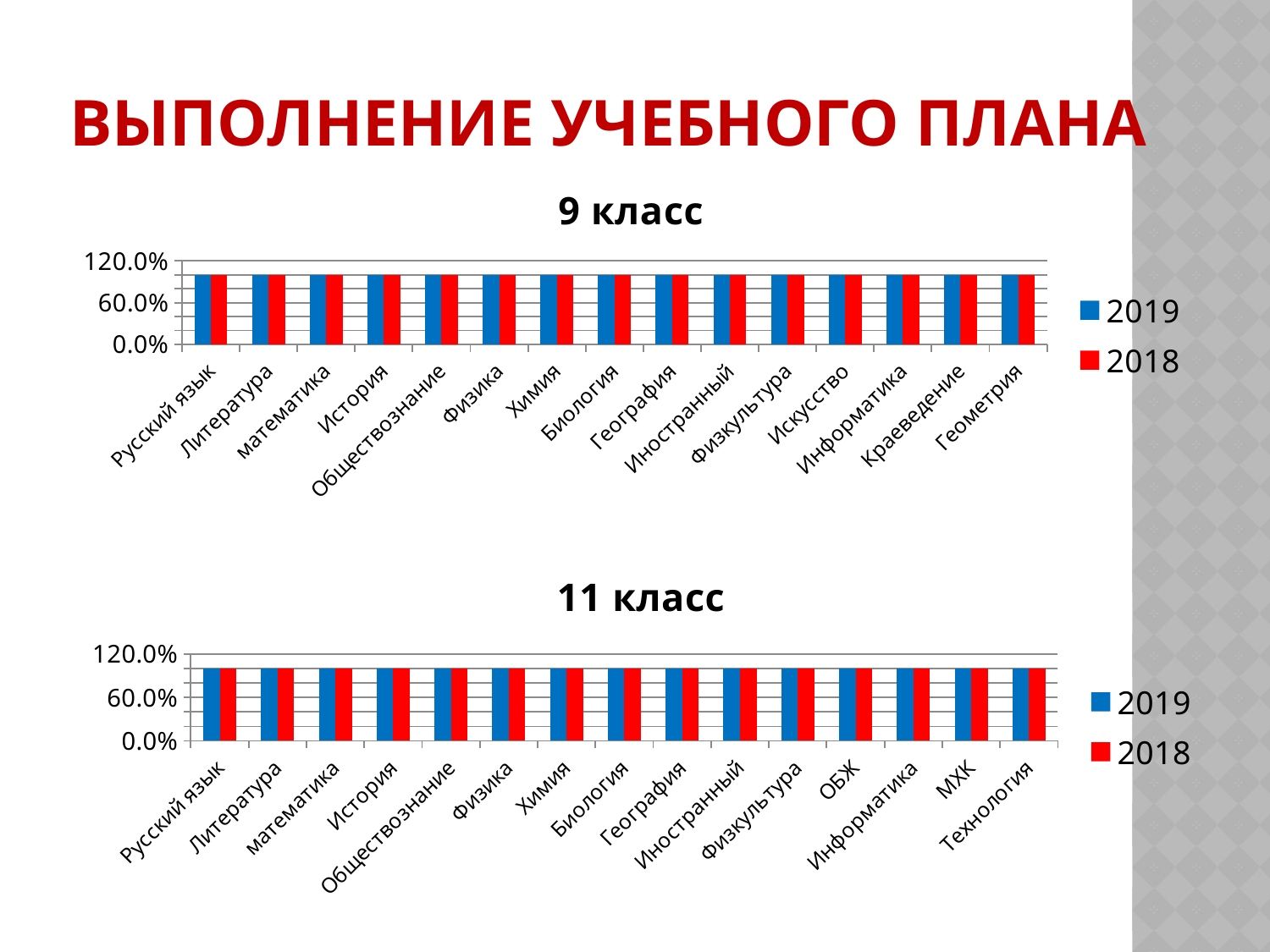
What kind of chart is the "11 класс" chart? bar chart What kind of chart is the "9 класс" chart? bar chart How many categories are shown on the x axis of the "11 класс" chart? 15 In the "11 класс" chart, is the 2018 value for Технология greater or less than 120.0%? less In the "9 класс" chart, which colour represents the 2018 series? red How many series does the legend of the "11 класс" chart list? 2 How many categories are shown on the x axis of the "9 класс" chart? 15 What are the two series named in the legend of the "11 класс" chart? 2019 and 2018 In the "9 класс" chart, is the 2018 value for Геометрия greater or less than 120.0%? less In the "11 класс" chart, is the 2019 value for ОБЖ greater or less than 60.0%? greater How many series does the legend of the "9 класс" chart list? 2